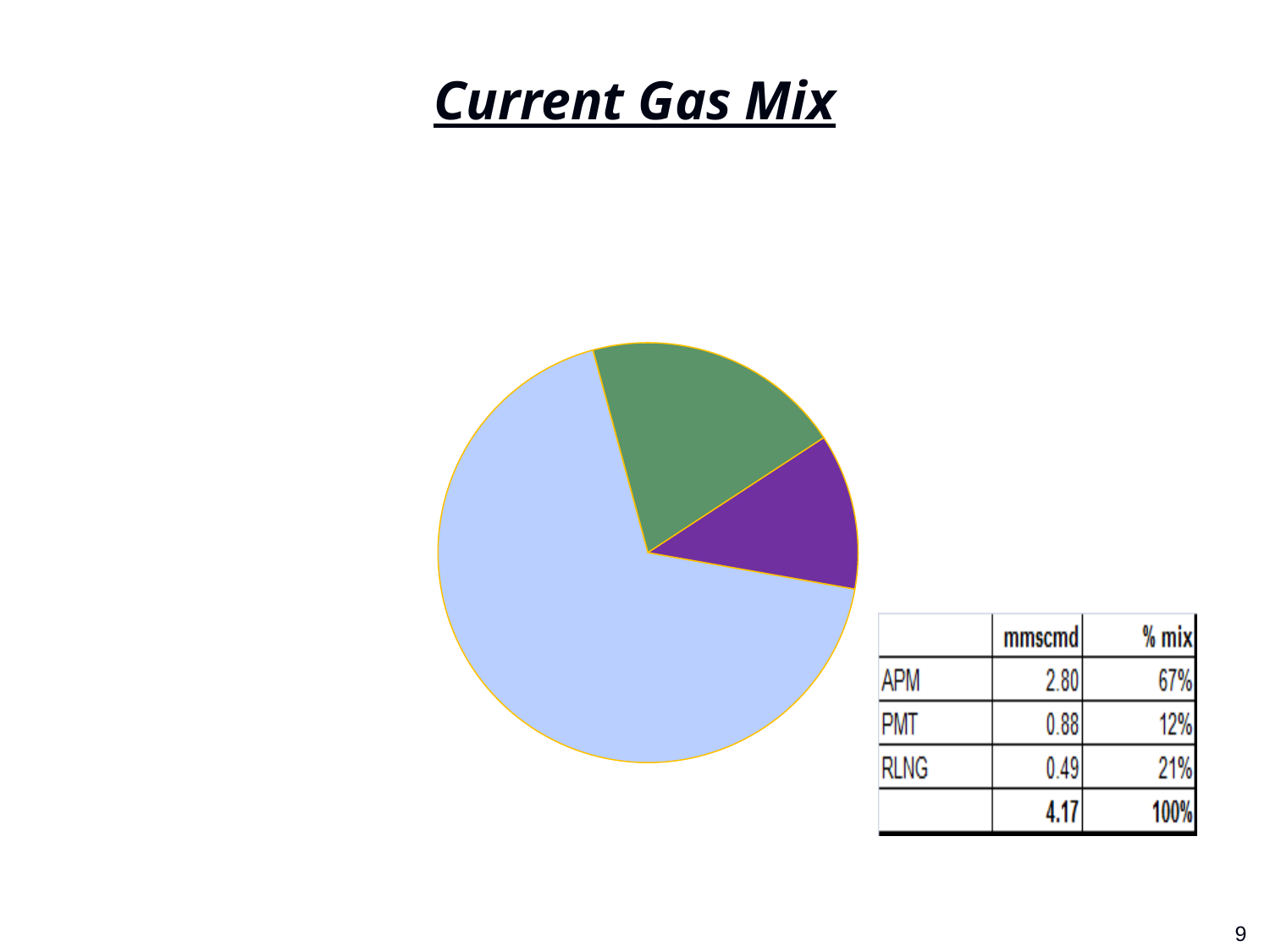
Which category has the highest % mix in the table? APM What colour is the largest slice of the pie chart? light blue What is the mmscmd value for APM in the table? 2.80 What share of the gas mix does APM account for, according to the table? 67% What is the total mmscmd shown in the table? 4.17 Which category has the lowest mmscmd value in the table? RLNG What kind of chart is shown on the slide? pie chart What % mix does the table give for RLNG? 21% What is the mmscmd value for RLNG in the table? 0.49 How many categories are listed in the table next to the pie chart? 3 What is the difference in % mix between APM and RLNG in the table? 46% What is the mmscmd value for PMT in the table? 0.88